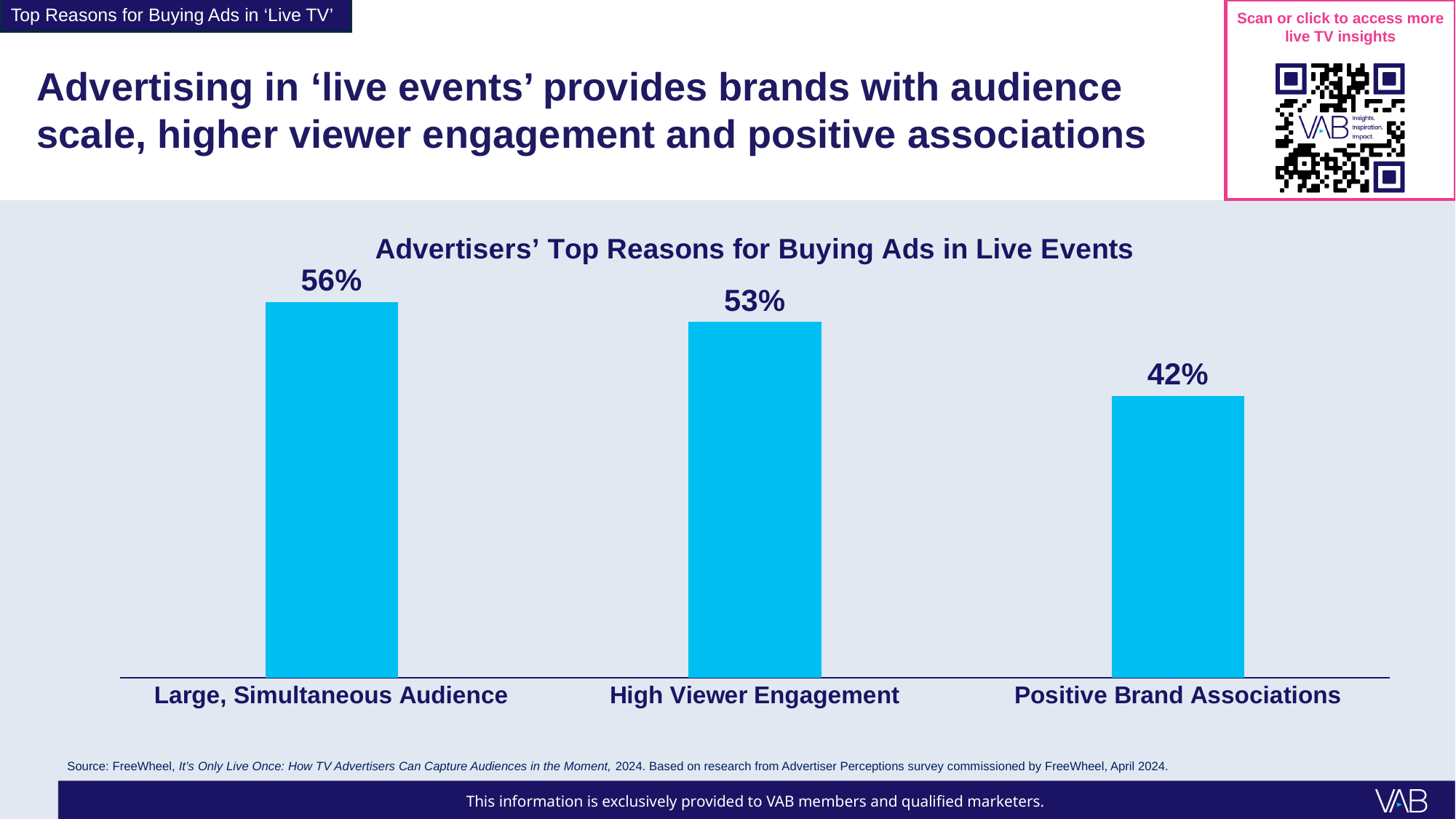
Do the values rise or fall moving from left to right across the chart? Fall What is the value shown for Positive Brand Associations? 42% How many reasons (categories) are shown in the chart? 3 What kind of chart is used on this slide? Bar chart What is the difference in percentage points between Large, Simultaneous Audience and Positive Brand Associations? 14 percentage points What is the value shown for High Viewer Engagement? 53% What is the difference in percentage points between High Viewer Engagement and Positive Brand Associations? 11 percentage points What percentage of advertisers cited Large, Simultaneous Audience as a top reason for buying ads in live events? 56% What is the title of the chart? Advertisers' Top Reasons for Buying Ads in Live Events Which reason has the lowest value in the chart? Positive Brand Associations Which reason has the highest value in the chart? Large, Simultaneous Audience Which is larger: the value for High Viewer Engagement or the value for Positive Brand Associations? High Viewer Engagement